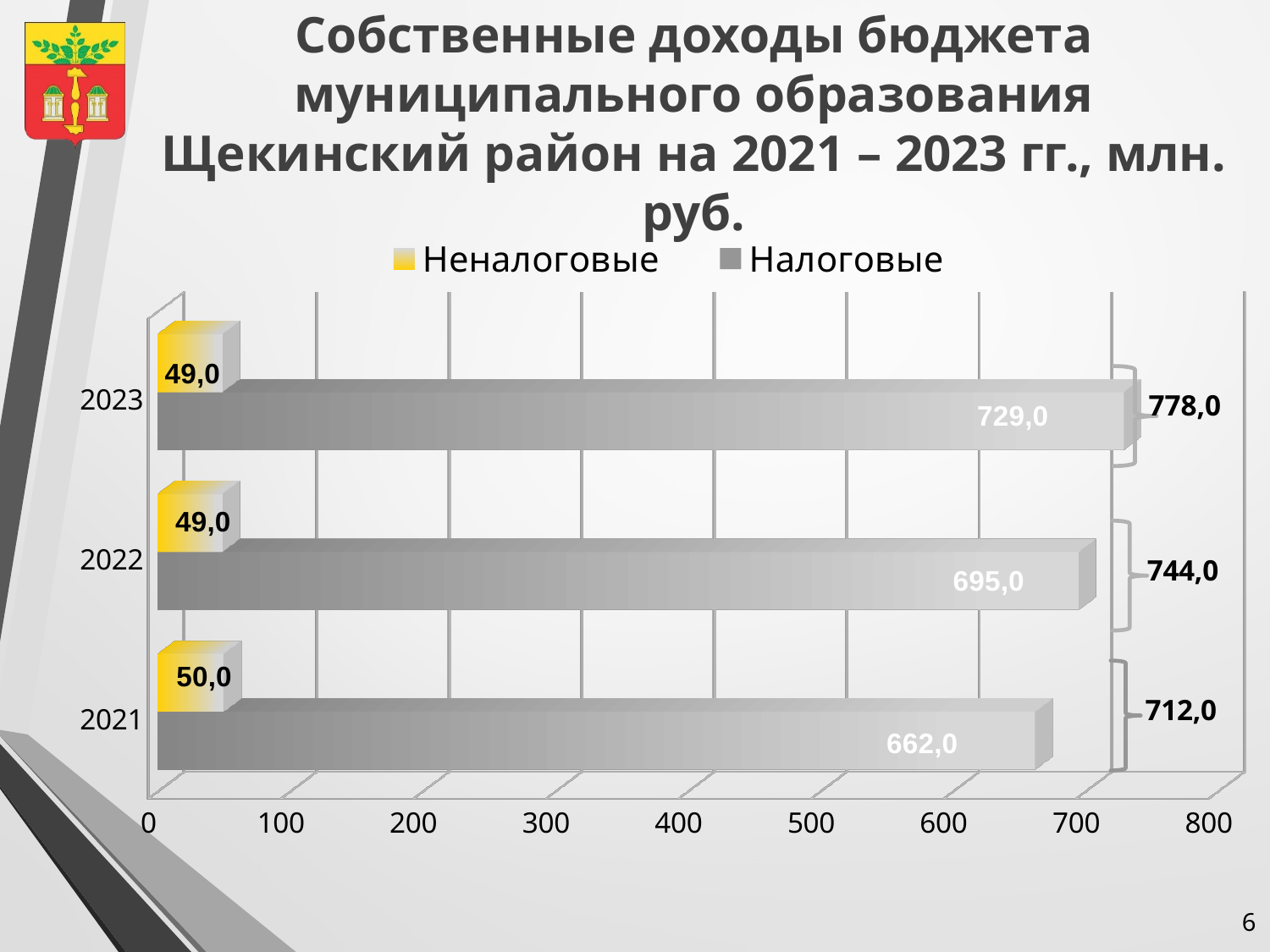
What is the value of Налоговые for 2023? 729,0 Do the Налоговые values rise or fall from 2021 to 2023? rise What is the value of Неналоговые for 2021? 50,0 How many years are shown on the chart? 3 Which year has the lowest Налоговые value? 2021 Which is larger, the Налоговые value for 2022 or for 2021? 2022 What kind of chart is shown on the slide? bar chart What is the value of Налоговые for 2022? 695,0 What total is shown by the bracket for 2021? 712,0 What is the difference between the Налоговые values for 2023 and 2021? 67,0 Which year has the highest Налоговые value? 2023 How many series does the legend list? 2